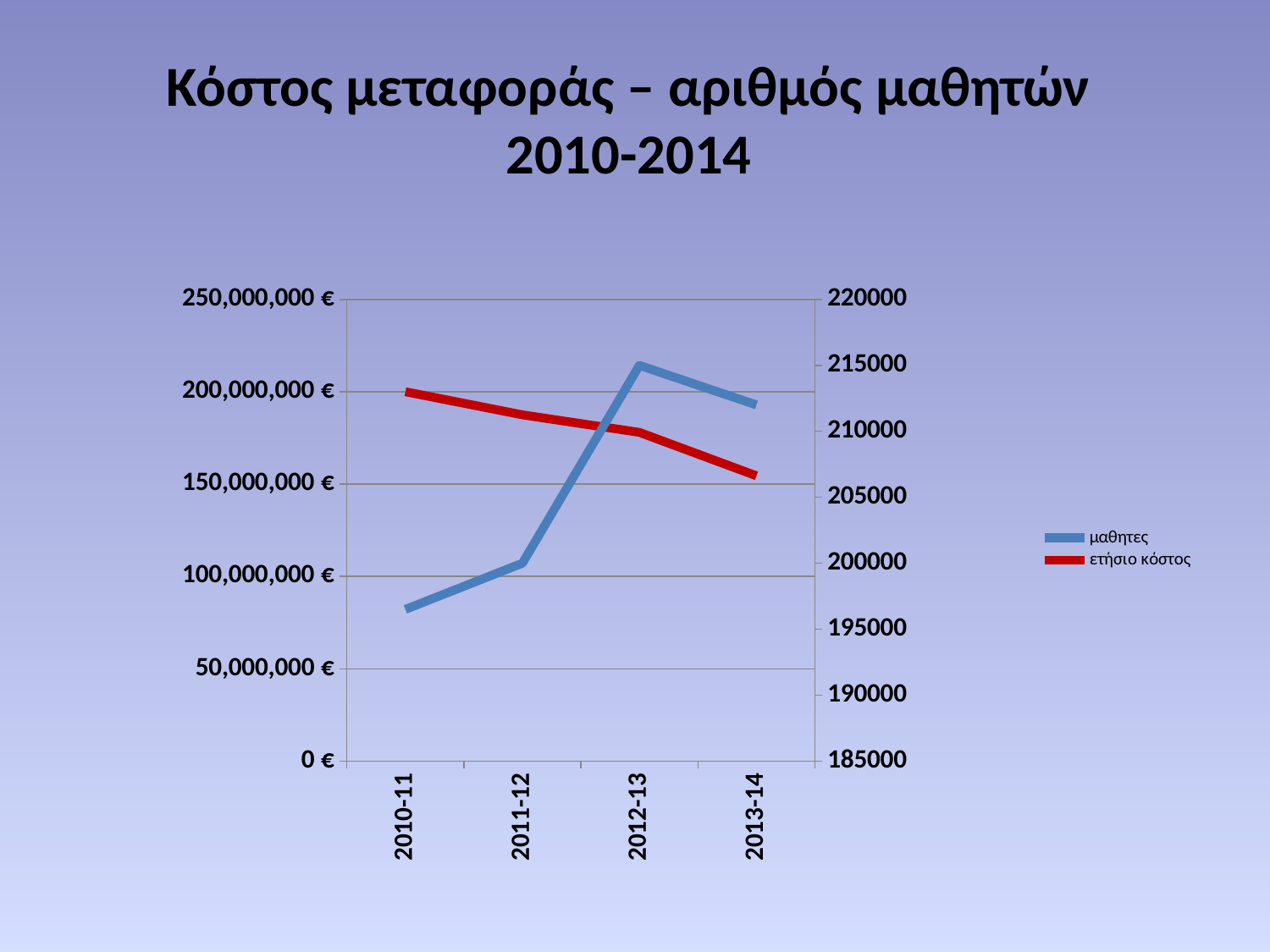
How many series does the legend list? 2 In which school year is the ετήσιο κόστος line at its highest point? 2010-11 Does the ετήσιο κόστος line rise or fall from 2010-11 to 2013-14? fall How many school years are plotted along the x axis? 4 In which school year is the ετήσιο κόστος line at its lowest point? 2013-14 What is the title of the chart? Κόστος μεταφοράς – αριθμός μαθητών 2010-2014 What kind of chart is shown on the slide? line chart In which school year is the μαθητες line at its lowest point? 2010-11 Which colour is used for the ετήσιο κόστος series? red Does the μαθητες line rise or fall from 2010-11 to 2012-13? rise For the μαθητες series, which is higher: 2011-12 or 2012-13? 2012-13 In which school year does the μαθητες line reach its highest point? 2012-13